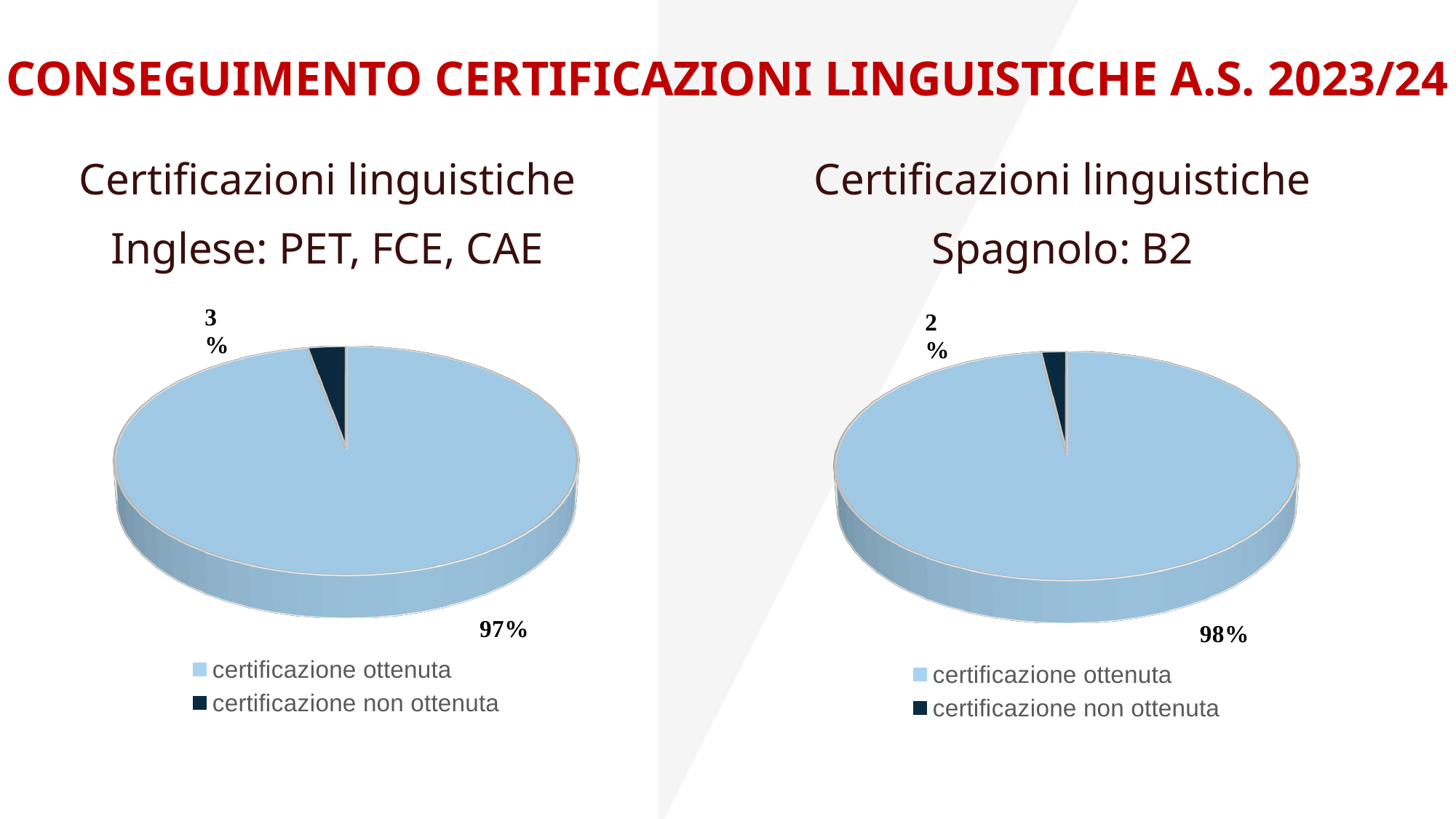
In the right chart (Spagnolo: B2), what percentage is shown for 'certificazione non ottenuta'? 2% What is the title of the right chart? Certificazioni linguistiche Spagnolo: B2 In the left chart (Inglese: PET, FCE, CAE), what percentage is shown for 'certificazione non ottenuta'? 3% In the left chart (Inglese: PET, FCE, CAE), what is the difference in percentage points between 'certificazione ottenuta' and 'certificazione non ottenuta'? 94 How many slices does the right chart (Spagnolo: B2) have? 2 In the left chart (Inglese: PET, FCE, CAE), which category has the smallest slice? certificazione non ottenuta In the right chart (Spagnolo: B2), which category has the largest slice? certificazione ottenuta In the right chart (Spagnolo: B2), what percentage is shown for 'certificazione ottenuta'? 98% How many entries does the legend of the left chart (Inglese: PET, FCE, CAE) list? 2 Which chart shows a higher percentage for 'certificazione ottenuta', the left (Inglese) or the right (Spagnolo)? Right (Spagnolo: B2) What type of chart is used on the left (Inglese: PET, FCE, CAE)? Pie chart In the left chart (Inglese: PET, FCE, CAE), what percentage is shown for 'certificazione ottenuta'? 97%